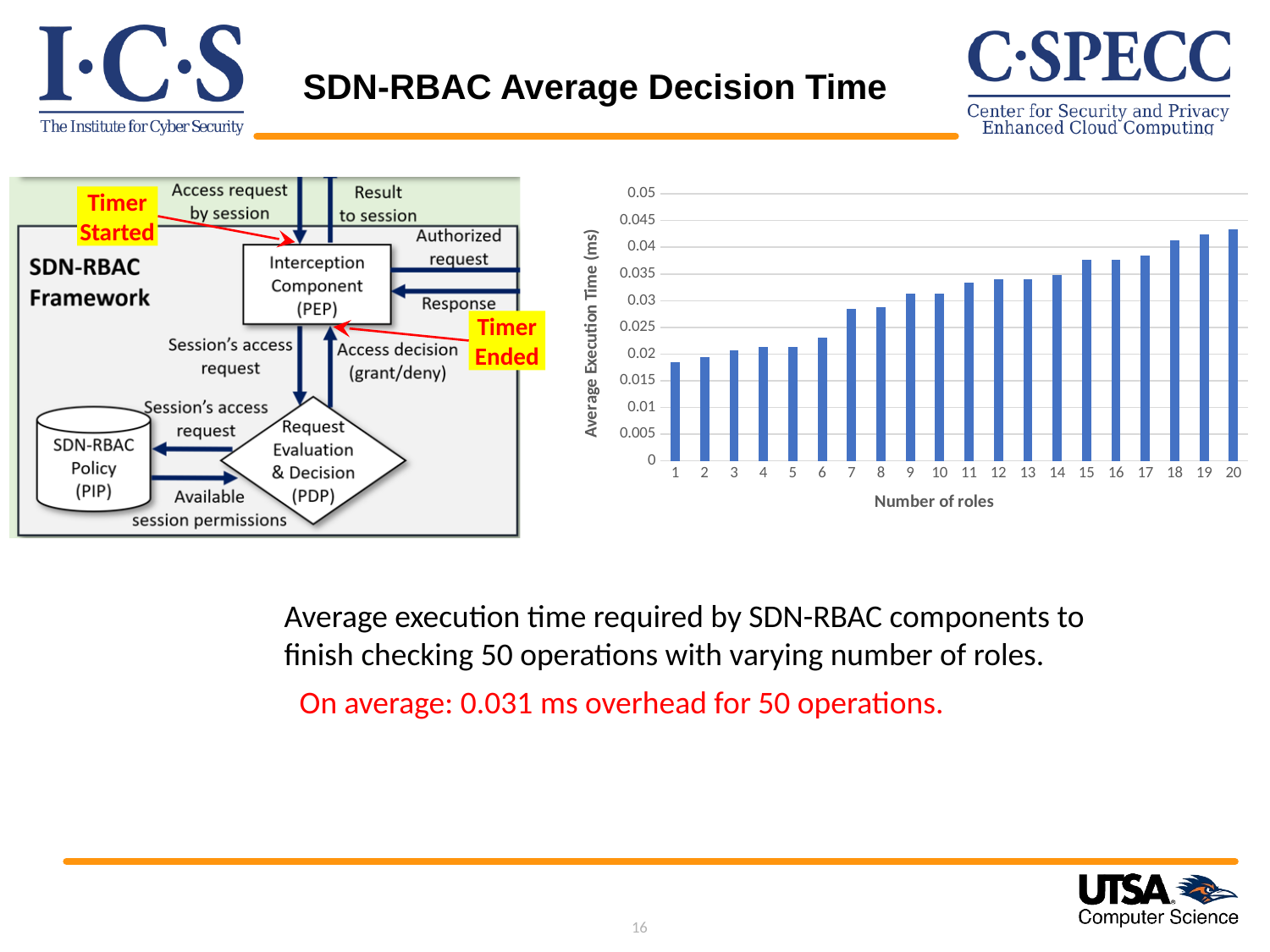
Which number of roles has the highest average execution time in the chart? 20 Which has a larger average execution time: 7 roles or 3 roles? 7 roles What kind of chart is shown on the slide? bar chart Is the average execution time for 20 roles greater or less than 0.04? greater Do the average execution times generally rise or fall as the number of roles increases? rise Is the average execution time for 6 roles greater or less than 0.025? less Which number of roles has the lowest average execution time in the chart? 1 How many categories (number of roles) are plotted on the x axis of the chart? 20 Is the average execution time for 15 roles greater or less than 0.035? greater What is the label of the x axis of the chart? Number of roles What is the label of the y axis of the chart? Average Execution Time (ms)